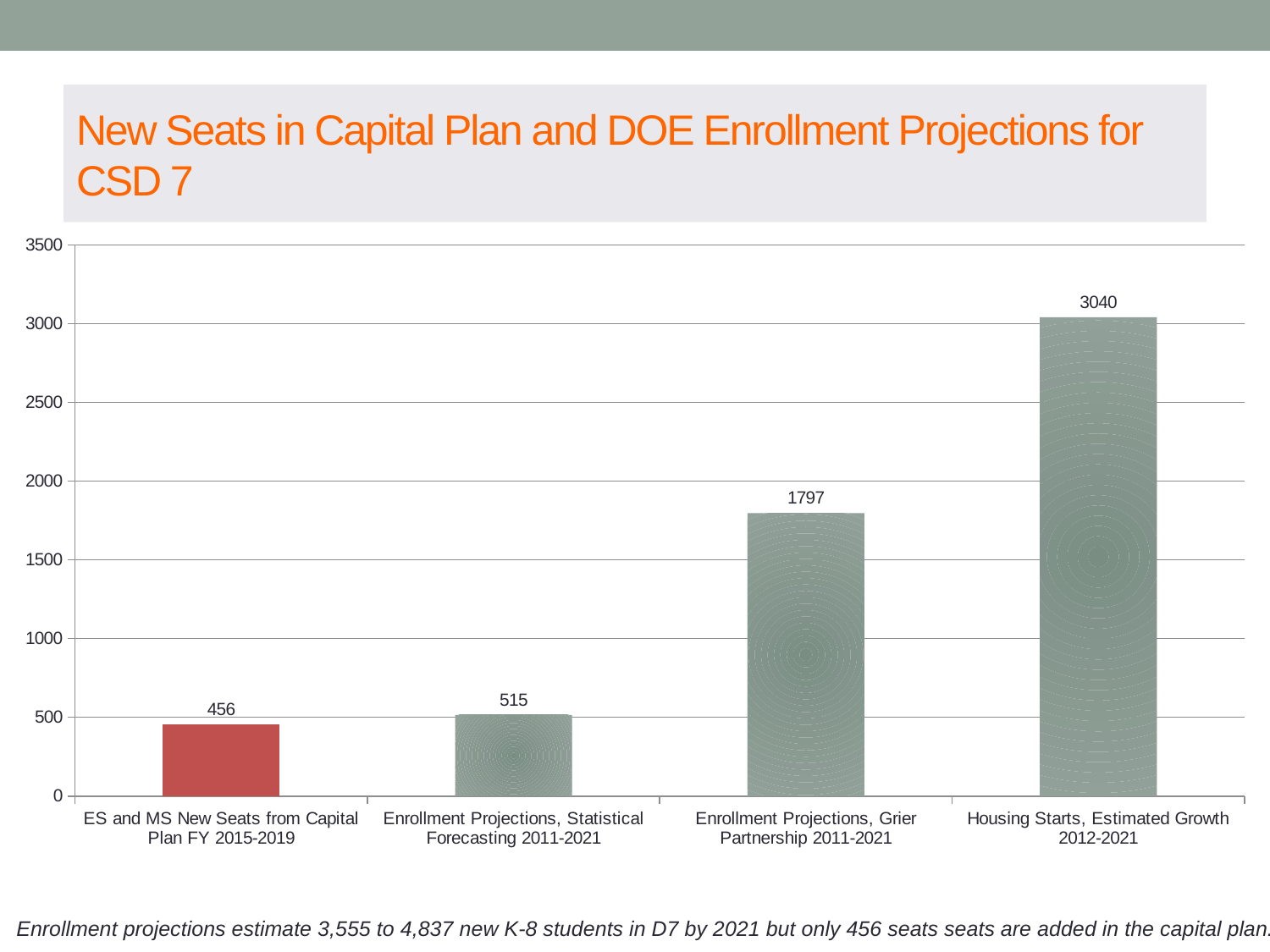
What is the value for Enrollment Projections, Statistical Forecasting 2011-2021? 515 Which category has the highest value? Housing Starts, Estimated Growth 2012-2021 Which is larger: the value for Enrollment Projections, Grier Partnership 2011-2021 or the value for Enrollment Projections, Statistical Forecasting 2011-2021? Enrollment Projections, Grier Partnership 2011-2021 What is the value for Housing Starts, Estimated Growth 2012-2021? 3040 What kind of chart is shown on the slide? Bar chart Which category has the lowest value? ES and MS New Seats from Capital Plan FY 2015-2019 What is the title of the chart on the slide? New Seats in Capital Plan and DOE Enrollment Projections for CSD 7 What is the value for ES and MS New Seats from Capital Plan FY 2015-2019? 456 How many categories are shown in the chart? 4 What is the difference between the Enrollment Projections, Statistical Forecasting 2011-2021 value and the ES and MS New Seats from Capital Plan FY 2015-2019 value? 59 What is the value for Enrollment Projections, Grier Partnership 2011-2021? 1797 What is the difference between the Housing Starts, Estimated Growth 2012-2021 value and the Enrollment Projections, Grier Partnership 2011-2021 value? 1243